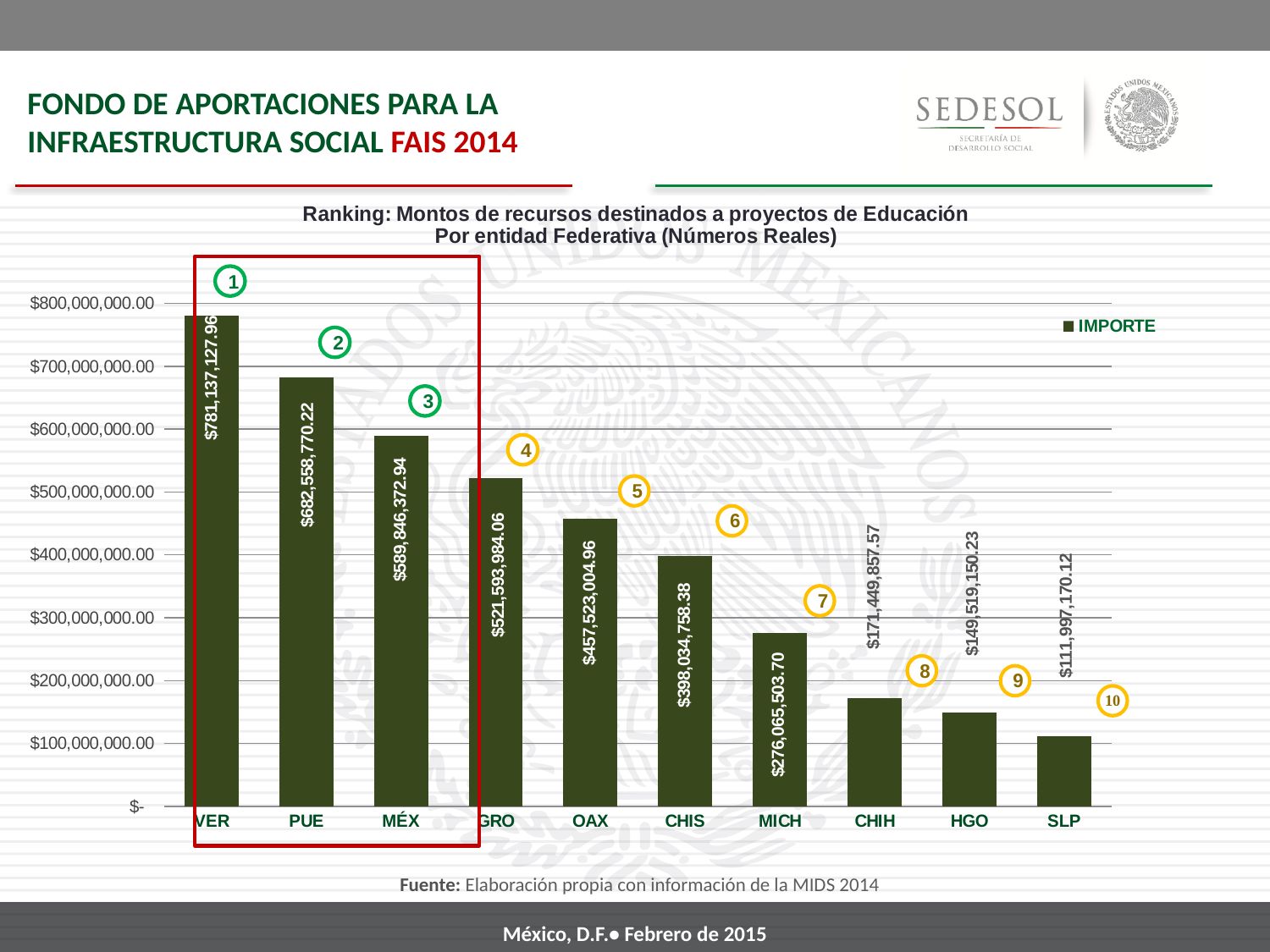
What kind of chart is shown on the slide? bar chart Which entity has the lowest value? SLP What is the difference between the values for CHIH and HGO? $21,930,707.34 What is the value for VER? $781,137,127.96 Which entity has the highest value? VER Is the value for MICH greater or less than $300,000,000.00? less How many series does the legend list? 1 What is the value for SLP? $111,997,170.12 Which is larger, the value for GRO or the value for CHIS? GRO How many entities are shown on the chart? 10 What is the value for OAX? $457,523,004.96 What is the difference between the values for VER and PUE? $98,578,357.74